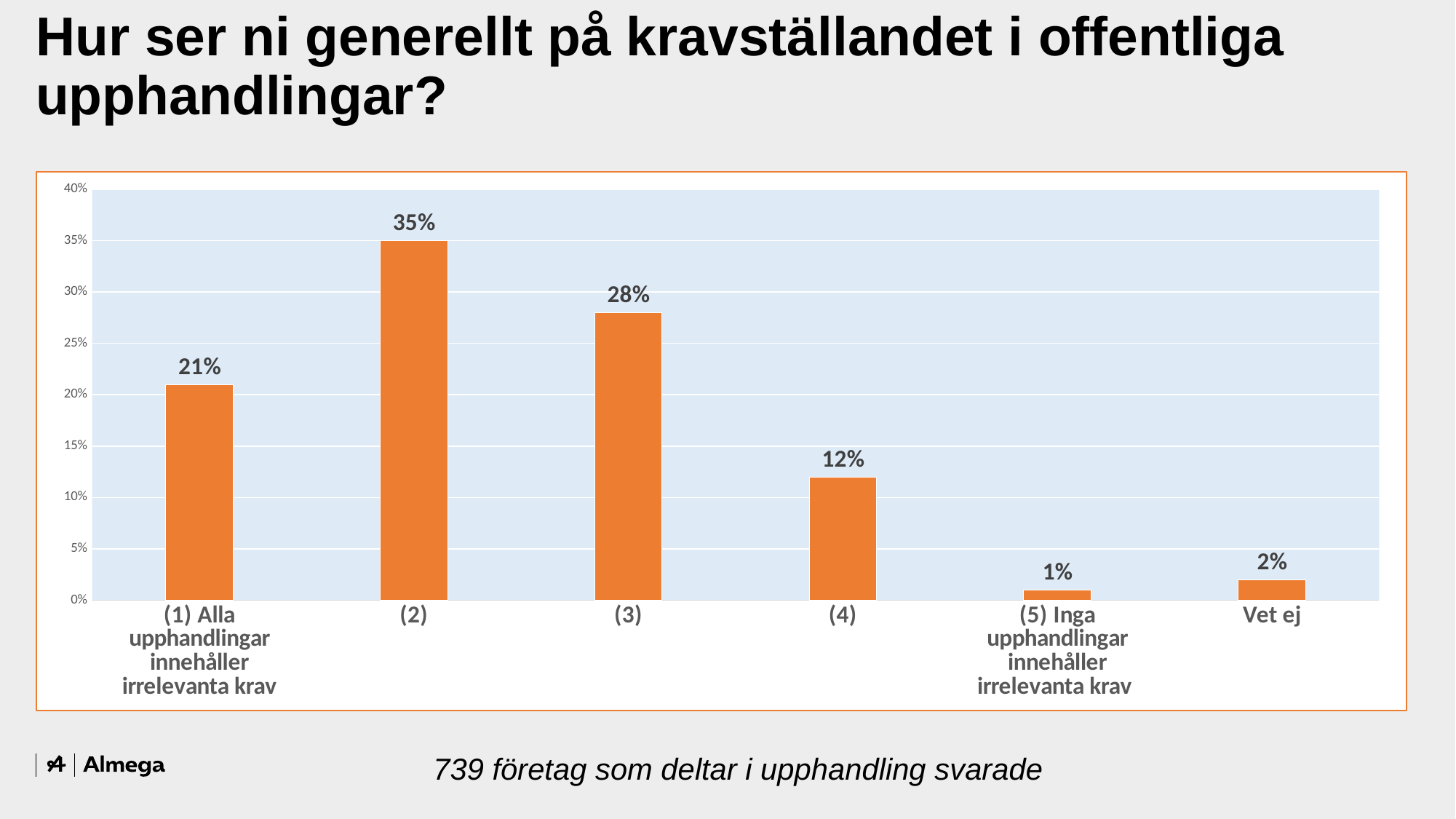
Which category has the highest value? (2) What is the value for "(5) Inga upphandlingar innehåller irrelevanta krav"? 1% How many categories are shown on the x axis? 6 What is the value for category (2)? 35% What colour are the bars in the chart? orange Which category has the lowest value? (5) Inga upphandlingar innehåller irrelevanta krav What is the value for "Vet ej"? 2% Is the value for (4) greater or less than 15%? less What kind of chart is shown on the slide? bar chart What is the difference between the values for (2) and (3)? 7% Which is larger, the value for (3) or the value for (4)? (3) What is the value for "(1) Alla upphandlingar innehåller irrelevanta krav"? 21%